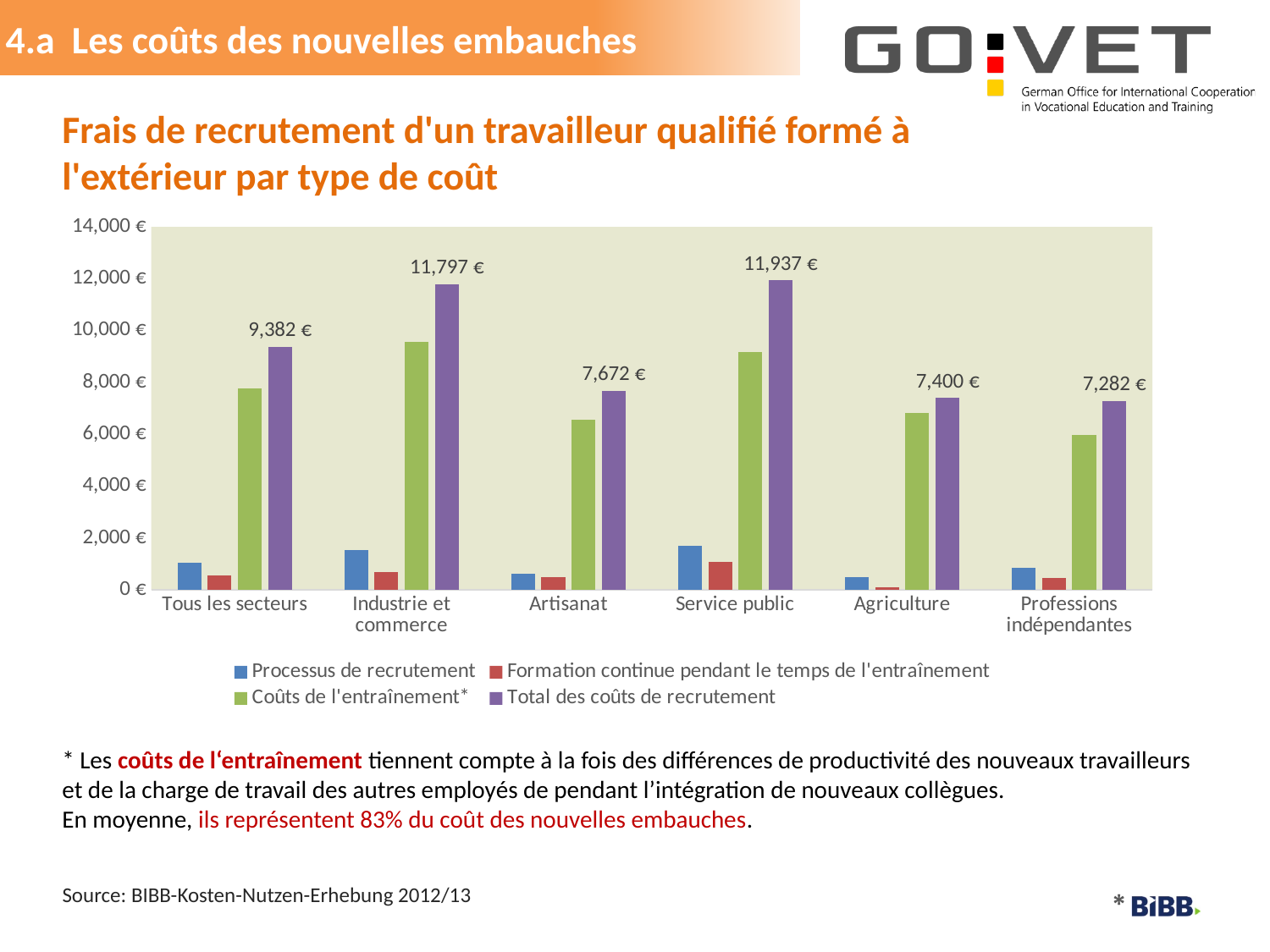
How many series does the legend list? 4 What is the value of Total des coûts de recrutement for Professions indépendantes? 7,282 € What is the difference in Total des coûts de recrutement between Tous les secteurs and Artisanat? 1,710 € Is the value of Processus de recrutement for Service public greater or less than 2,000 €? less Which category has the lowest Total des coûts de recrutement? Professions indépendantes What is the value of Total des coûts de recrutement for Tous les secteurs? 9,382 € How many categories are shown on the x axis of the chart? 6 Is the value of Coûts de l'entraînement* for Industrie et commerce greater or less than 8,000 €? greater What is the difference in Total des coûts de recrutement between Service public and Industrie et commerce? 140 € What is the value of Total des coûts de recrutement for Service public? 11,937 € Which category has the highest Total des coûts de recrutement? Service public Which has a larger Total des coûts de recrutement, Agriculture or Artisanat? Artisanat